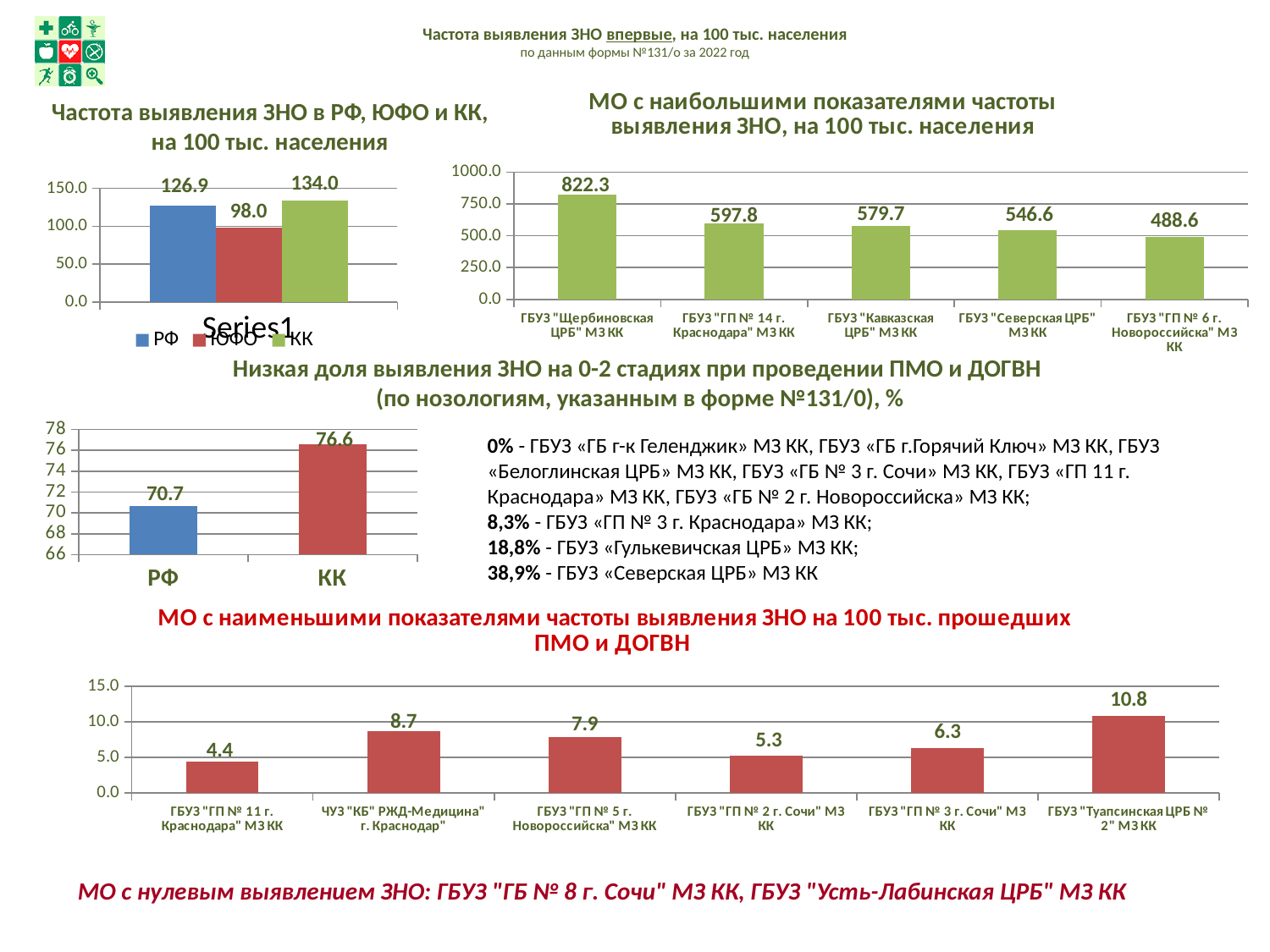
In the top-left chart 'Частота выявления ЗНО в РФ, ЮФО и КК', which category has the highest value? КК In the bottom chart 'МО с наименьшими показателями частоты выявления ЗНО', what is the value for ГБУЗ "ГП № 2 г. Сочи" МЗ КК? 5.3 In the middle-left chart 'Низкая доля выявления ЗНО на 0-2 стадиях', which is larger, the value for РФ or for КК? КК What kind of chart is the bottom chart 'МО с наименьшими показателями частоты выявления ЗНО'? bar chart How many organisations are shown in the top-right chart 'МО с наибольшими показателями частоты выявления ЗНО'? 5 In the top-right chart 'МО с наибольшими показателями частоты выявления ЗНО', which organisation has the lowest value? ГБУЗ "ГП № 6 г. Новороссийска" МЗ КК In the top-left chart 'Частота выявления ЗНО в РФ, ЮФО и КК', what is the difference between the values for КК and РФ? 7.1 How many series does the legend of the top-left chart 'Частота выявления ЗНО в РФ, ЮФО и КК' list? 3 In the middle-left chart 'Низкая доля выявления ЗНО на 0-2 стадиях', what is the value for КК? 76.6 In the top-left chart 'Частота выявления ЗНО в РФ, ЮФО и КК, на 100 тыс. населения', what is the value for ЮФО? 98.0 In the top-right chart 'МО с наибольшими показателями частоты выявления ЗНО', what is the value for ГБУЗ "Щербиновская ЦРБ" МЗ КК? 822.3 In the top-right chart 'МО с наибольшими показателями частоты выявления ЗНО', do the values rise or fall from left to right? fall